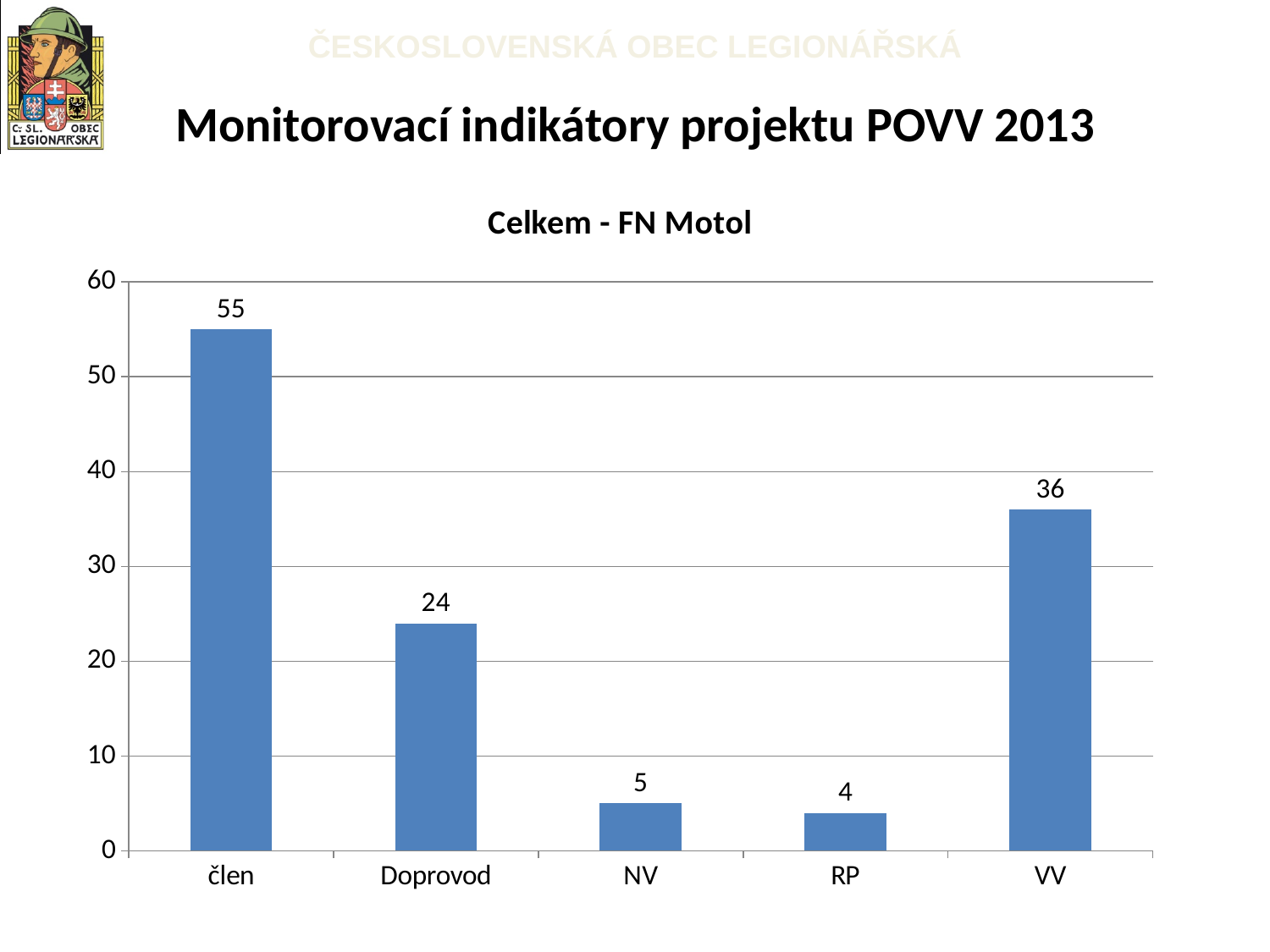
What is the value for RP? 4 How many categories are shown on the x axis? 5 What is the title of the chart? Celkem - FN Motol What is the value for člen? 55 What is the difference between the values for NV and RP? 1 Which is larger, the value for Doprovod or the value for VV? VV Which category has the highest value? člen Which category has the lowest value? RP What is the value for Doprovod? 24 What is the value for VV? 36 What kind of chart is shown? bar chart What is the difference between the values for člen and VV? 19